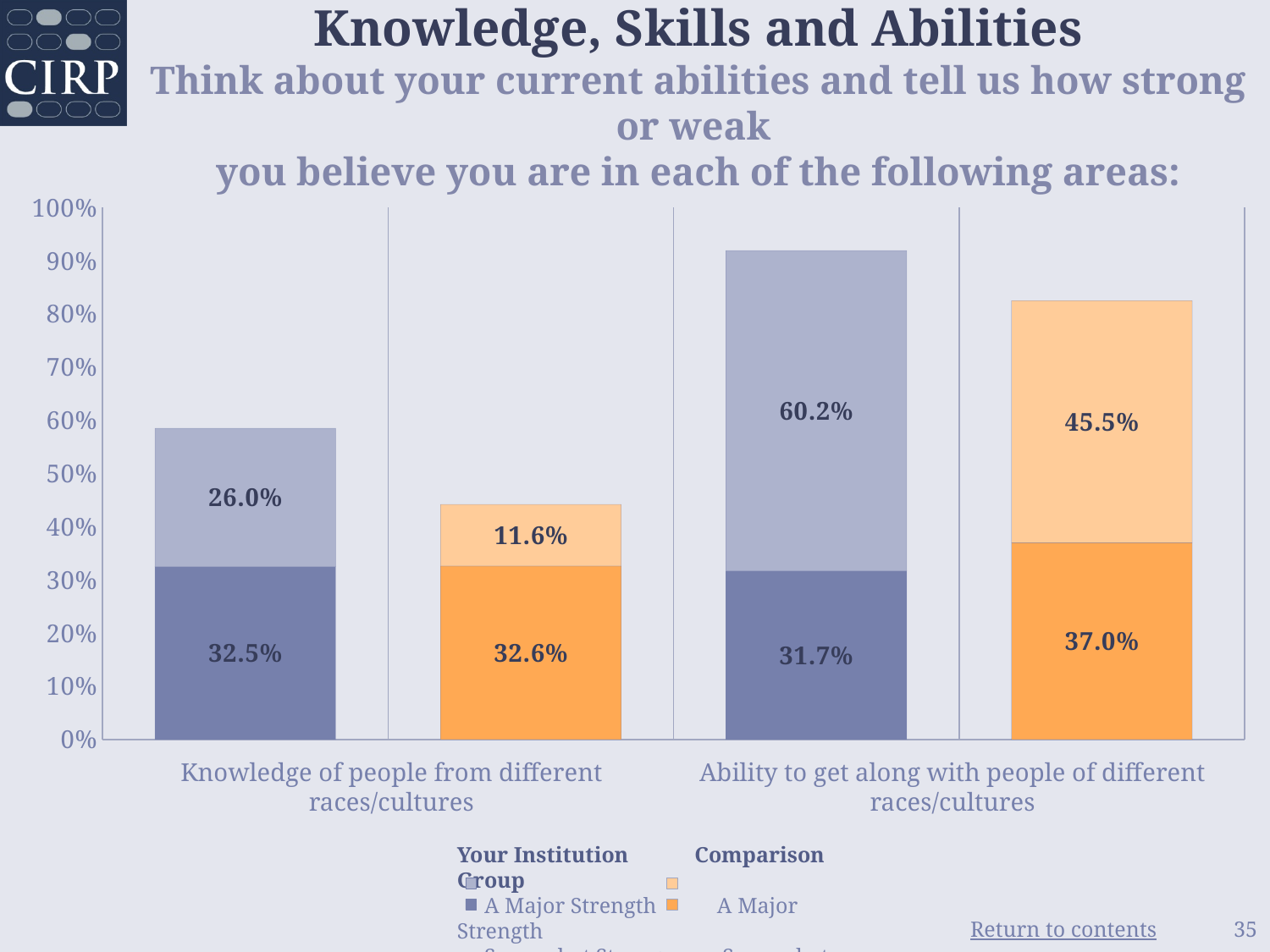
What is the 'A Major Strength' value for Your Institution for 'Knowledge of people from different races/cultures'? 32.5% What is the value of the upper (lighter) segment of the Comparison Group bar for 'Knowledge of people from different races/cultures'? 11.6% Which colour represents Your Institution in the chart? Blue What is the total of the Your Institution stacked bar for 'Ability to get along with people of different races/cultures'? 91.9% What is the 'A Major Strength' value for the Comparison Group for 'Ability to get along with people of different races/cultures'? 37.0% Which is larger for 'Ability to get along with people of different races/cultures': the 'A Major Strength' value for Your Institution or for the Comparison Group? Comparison Group What is the value of the upper (lighter) segment of the Your Institution bar for 'Ability to get along with people of different races/cultures'? 60.2% What is the total of the Comparison Group stacked bar for 'Knowledge of people from different races/cultures'? 44.2% What is the difference between the upper segment values of the Your Institution bar (26.0%) and the Comparison Group bar (11.6%) for 'Knowledge of people from different races/cultures'? 14.4% How many categories are shown on the x axis? 2 Is the total height of the Your Institution bar for 'Ability to get along with people of different races/cultures' greater or less than 90%? greater What kind of chart is shown on the slide? Stacked bar chart